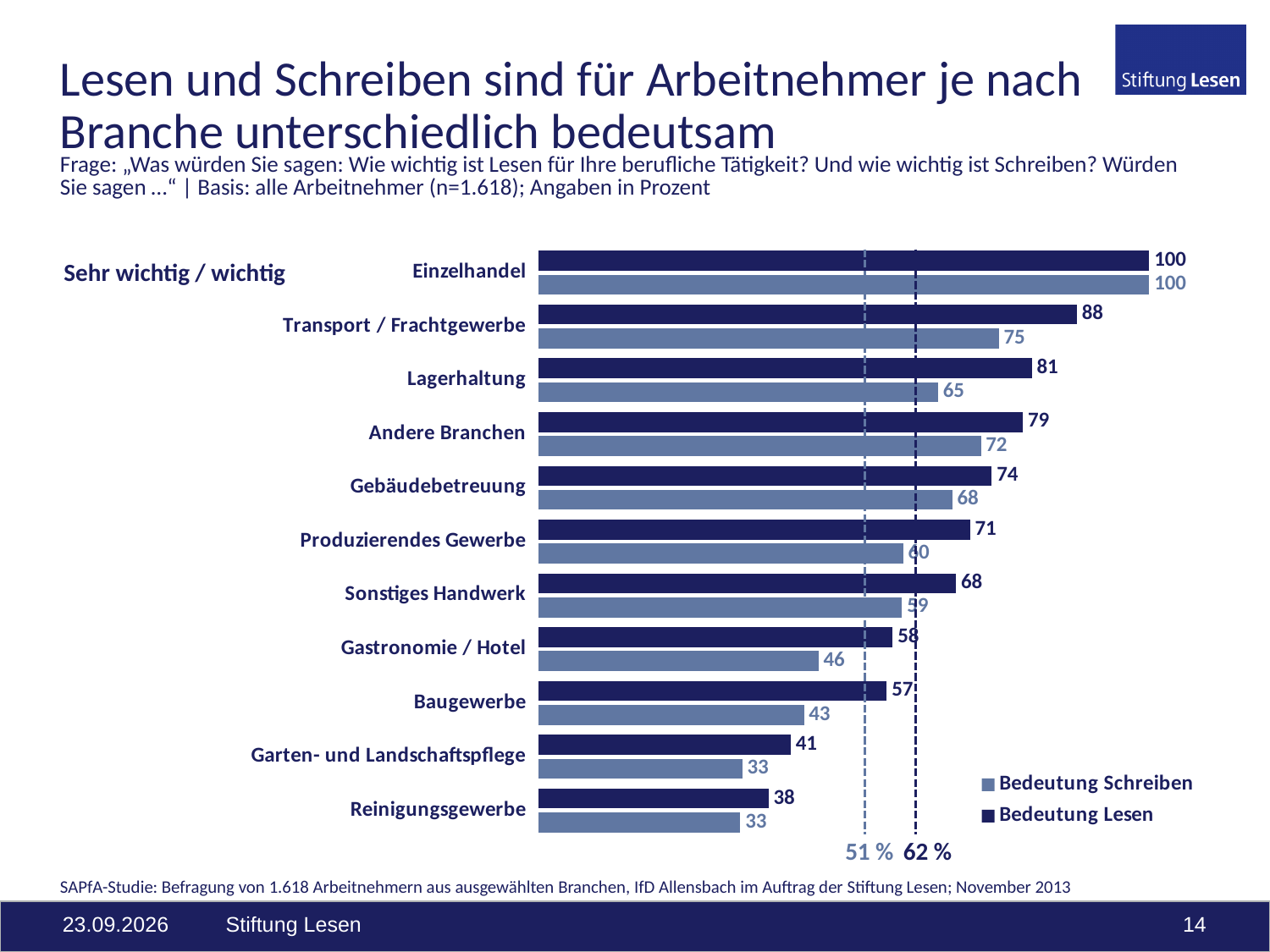
How many categories (Branchen) are shown in the chart? 11 What is the difference between the Bedeutung Lesen values for Einzelhandel and Reinigungsgewerbe? 62 What is the value for Bedeutung Schreiben for Gastronomie / Hotel? 46 What is the difference between Bedeutung Lesen and Bedeutung Schreiben for Lagerhaltung? 16 How many series does the legend list? 2 What is the value for Bedeutung Lesen for Transport / Frachtgewerbe? 88 What values are marked by the two dashed vertical lines in the chart? 51 % and 62 % What is the value for Bedeutung Schreiben for Lagerhaltung? 65 Which is larger for Baugewerbe: Bedeutung Lesen or Bedeutung Schreiben? Bedeutung Lesen Which category has the lowest value for Bedeutung Lesen? Reinigungsgewerbe What kind of chart is shown on the slide? Bar chart Which category has the highest value for Bedeutung Lesen? Einzelhandel